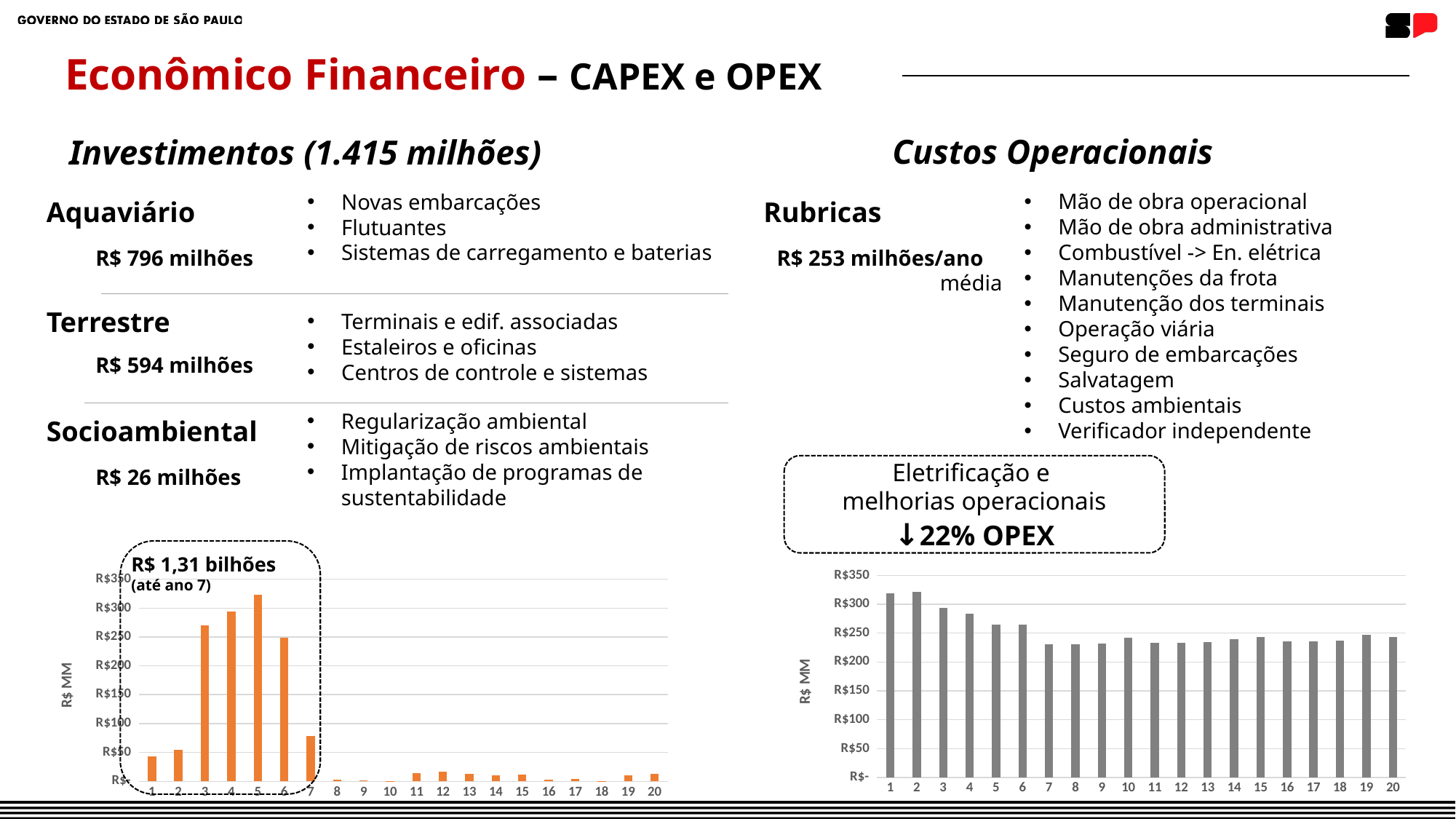
In the left chart, is the value for year 7 greater or less than R$100? less In the right chart, which is larger, the value for year 3 or the value for year 10? year 3 In the right chart, is the value for year 7 greater or less than R$250? less What is the y-axis label of the right chart? R$ MM In the left chart, is the value for year 5 greater or less than R$300? greater In the right chart (grey bars), do the values rise or fall from year 1 to year 7? fall In the left chart, which is larger, the value for year 3 or the value for year 4? year 4 How many years (categories) are shown on the x axis of the left chart? 20 What kind of chart is the chart on the left (orange bars)? bar chart In the left chart, which year has the highest bar? 5